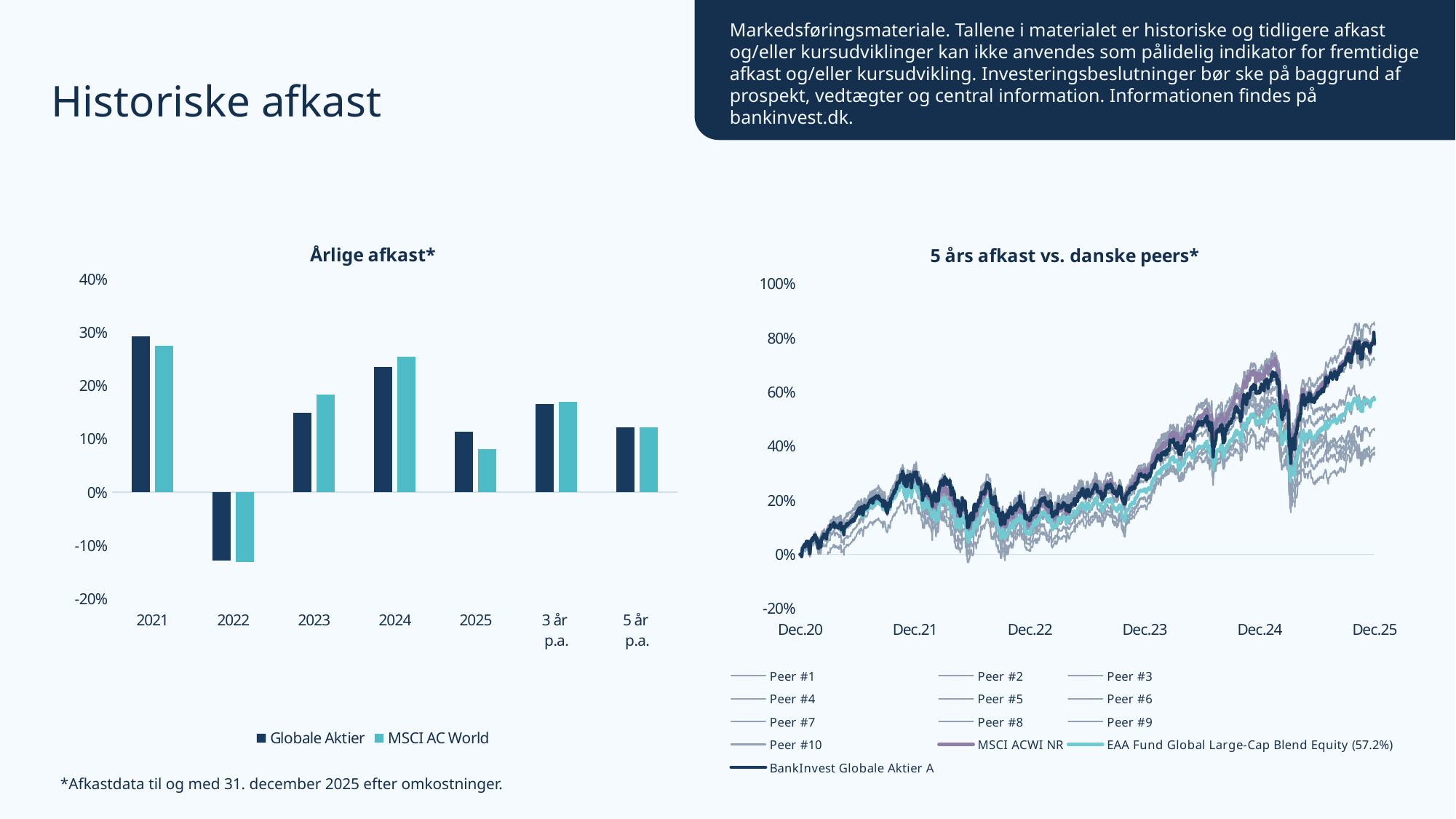
In the 'Årlige afkast*' chart, which category has the lowest value for MSCI AC World? 2022 In the 'Årlige afkast*' chart, is the value for MSCI AC World in 2022 greater or less than -10%? less In the 'Årlige afkast*' chart, which series has the larger value in 2025, Globale Aktier or MSCI AC World? Globale Aktier In the 'Årlige afkast*' chart, how many series does the legend list? 2 In the '5 års afkast vs. danske peers*' chart, what kind of chart is shown? line chart In the 'Årlige afkast*' chart, which series has the larger value in 2023, Globale Aktier or MSCI AC World? MSCI AC World In the '5 års afkast vs. danske peers*' chart, how many series does the legend list? 13 In the 'Årlige afkast*' chart, what kind of chart is shown? bar chart In the 'Årlige afkast*' chart, which year has the highest value for Globale Aktier? 2021 In the '5 års afkast vs. danske peers*' chart, is the value for BankInvest Globale Aktier A at Dec.25 greater or less than 60%? greater In the 'Årlige afkast*' chart, is the value for Globale Aktier in 2021 greater or less than 20%? greater In the 'Årlige afkast*' chart, how many categories are shown on the x axis? 7